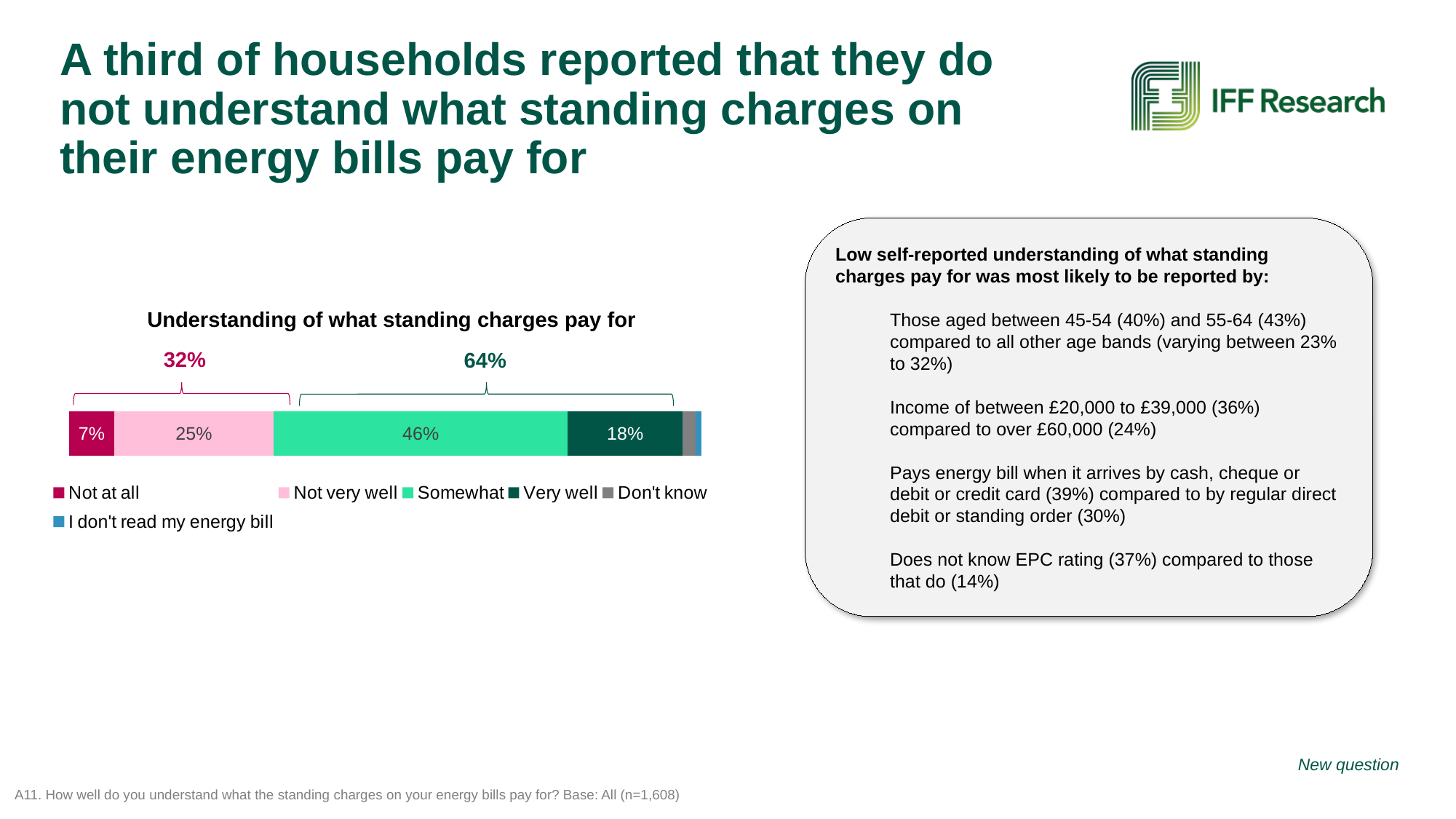
Which is larger, the share answering 'Not very well' or the share answering 'Very well'? Not very well What is the combined percentage for 'Somewhat' and 'Very well', as shown by the bracket above the bar? 64% What percentage of households answered 'Not very well'? 25% What is the title of the chart? Understanding of what standing charges pay for How many response categories does the legend list? 6 What type of chart is used to show understanding of what standing charges pay for? Stacked bar chart What percentage of households answered 'Very well'? 18% What is the difference in percentage points between 'Somewhat' and 'Very well'? 28 What percentage of households answered 'Not at all'? 7% What is the combined percentage for 'Not at all' and 'Not very well', as shown by the bracket above the bar? 32% What percentage of households said they understand what standing charges pay for 'Somewhat'? 46% Which response category has the largest share of households? Somewhat